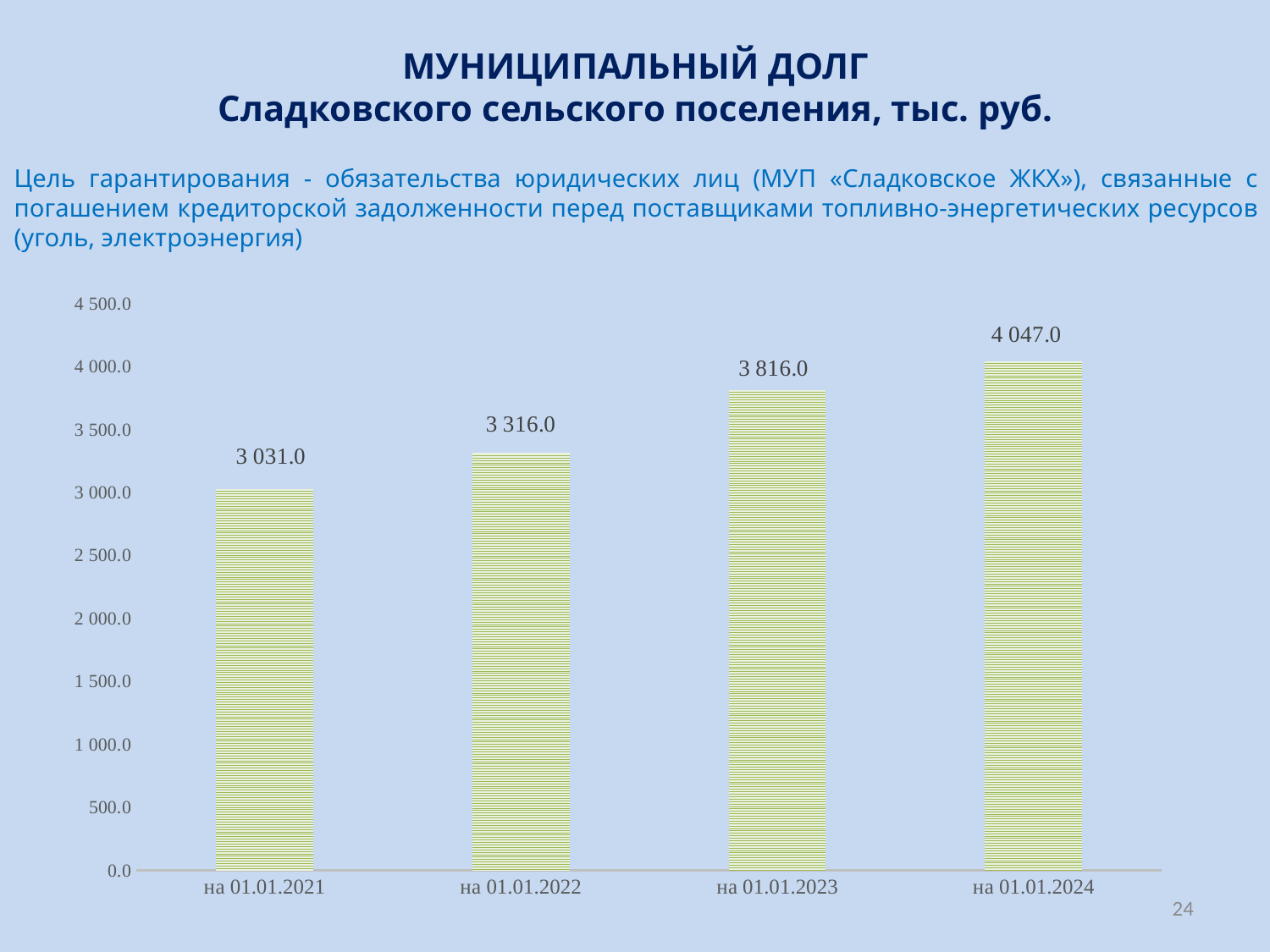
Which date has the lowest municipal debt? на 01.01.2021 What is the municipal debt value for на 01.01.2021? 3 031.0 Do the values rise or fall from на 01.01.2021 to на 01.01.2024? rise What is the municipal debt value for на 01.01.2024? 4 047.0 What is the municipal debt value for на 01.01.2023? 3 816.0 Which is larger, the value for на 01.01.2022 or на 01.01.2023? на 01.01.2023 What is the difference between the values for на 01.01.2024 and на 01.01.2021? 1 016.0 Is the value for на 01.01.2024 greater or less than 4 000.0? greater What kind of chart is shown on the slide? bar chart Which date has the highest municipal debt? на 01.01.2024 What is the difference between the values for на 01.01.2022 and на 01.01.2021? 285.0 How many dates are shown on the x axis of the chart? 4